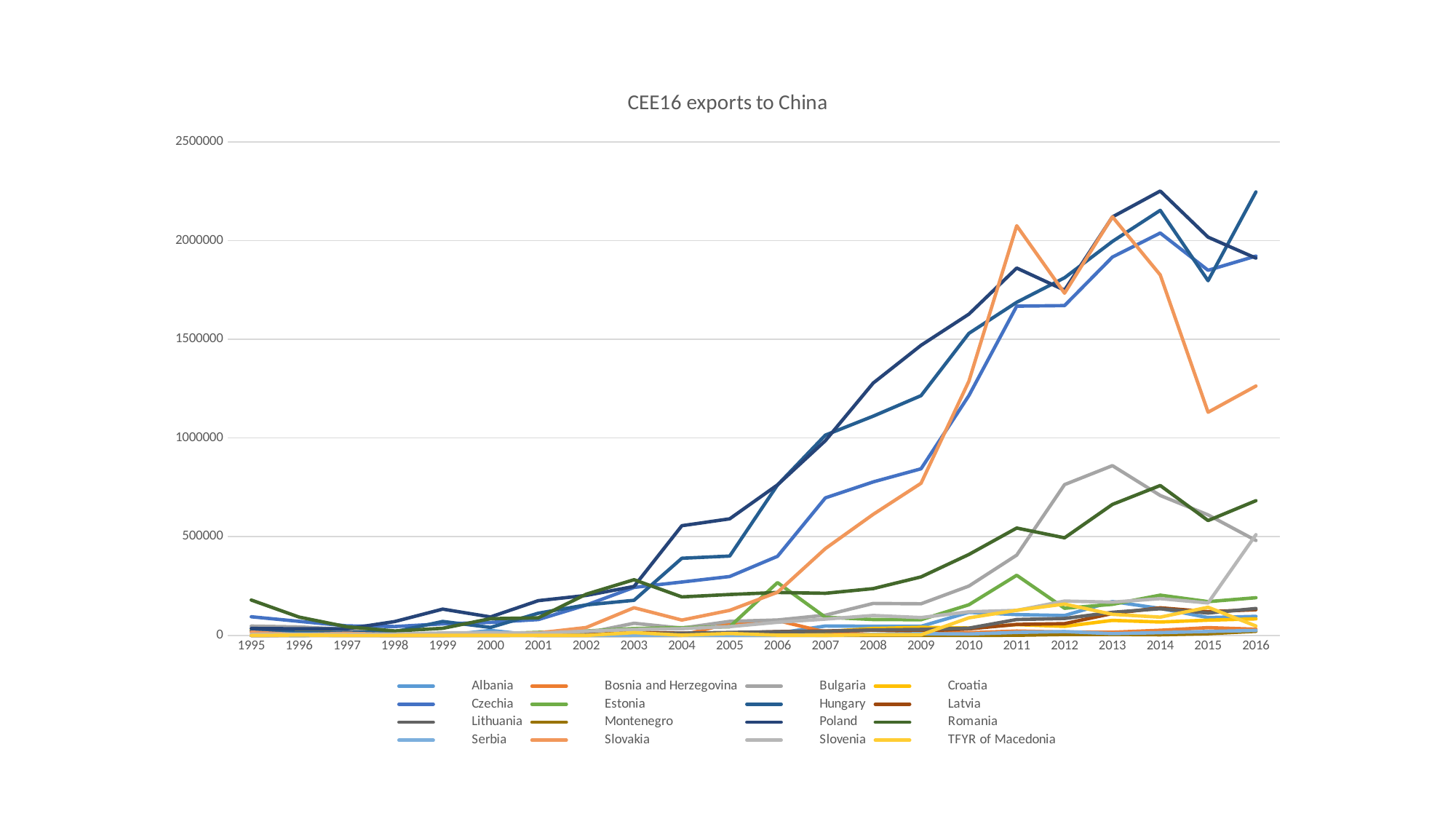
Is the value for Slovakia in 2011 greater or less than 2000000? greater Is the value for Slovakia in 2016 greater or less than 1500000? less In which year does Slovakia reach its highest value? 2013 Is the value for Romania in 2016 greater or less than 500000? greater What kind of chart is shown on the slide? line chart How many series does the legend list? 16 How many years are shown on the x axis? 22 What is the first year shown on the x axis? 1995 Do the values for Slovakia rise or fall from 2011 to 2015? fall Which is larger in 2016, the value for Slovakia or the value for Romania? Slovakia What is the title of the chart? CEE16 exports to China